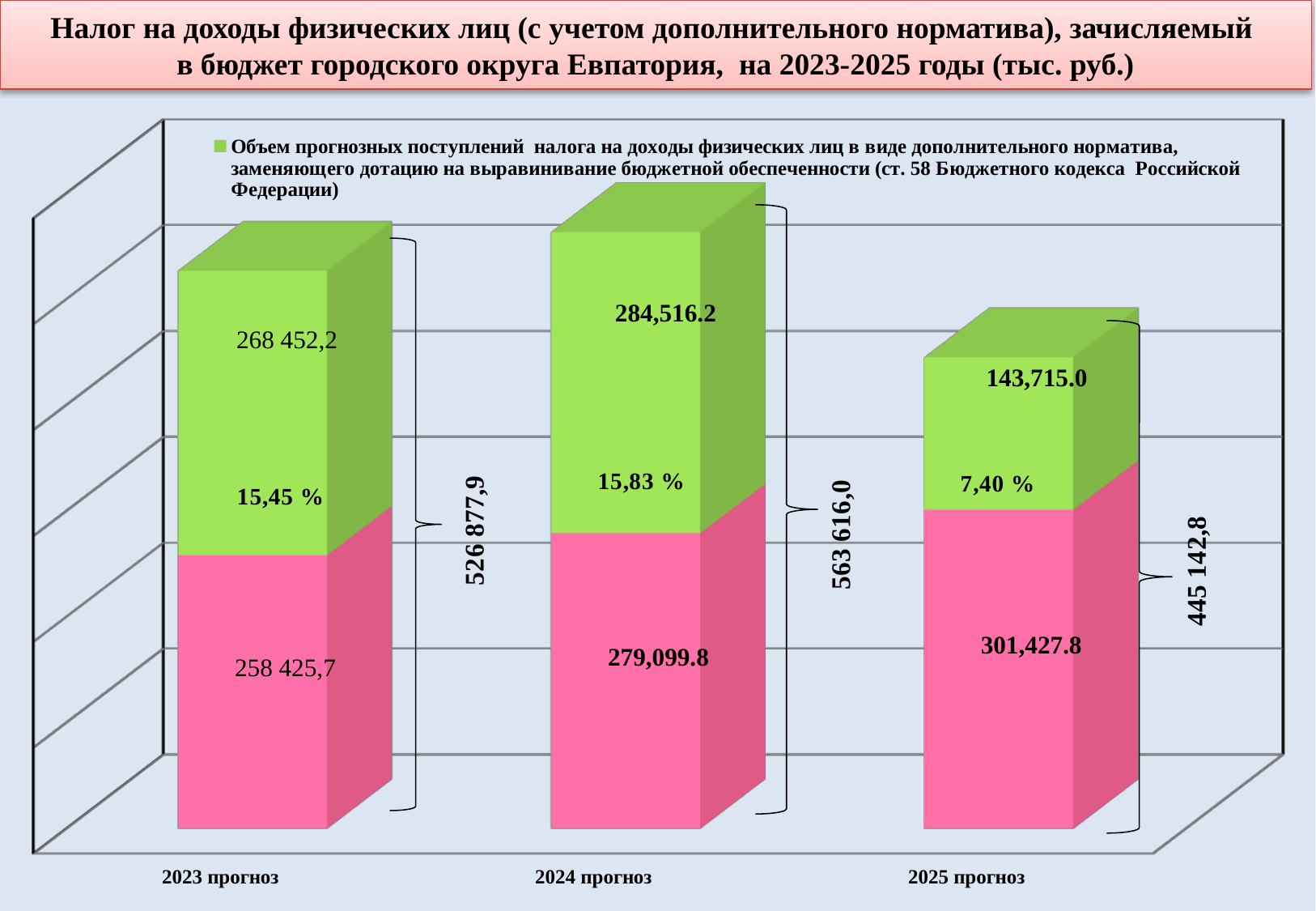
What is the value of the green segment for 2025 прогноз? 143,715.0 What type of chart is shown on the slide? stacked bar chart How many categories (years) are shown on the x axis of the chart? 3 Which is larger for 2025 прогноз: the green segment or the pink segment? the pink segment What total is shown next to the bar for 2024 прогноз? 563 616,0 Which year has the highest total bar? 2024 прогноз What is the value of the pink segment for 2024 прогноз? 279,099.8 What total is shown next to the bar for 2025 прогноз? 445 142,8 Which year has the lowest total bar? 2025 прогноз What percentage is printed on the bar for 2025 прогноз? 7,40 % What is the value of the green segment for 2023 прогноз? 268 452,2 What is the value of the pink segment for 2025 прогноз? 301,427.8